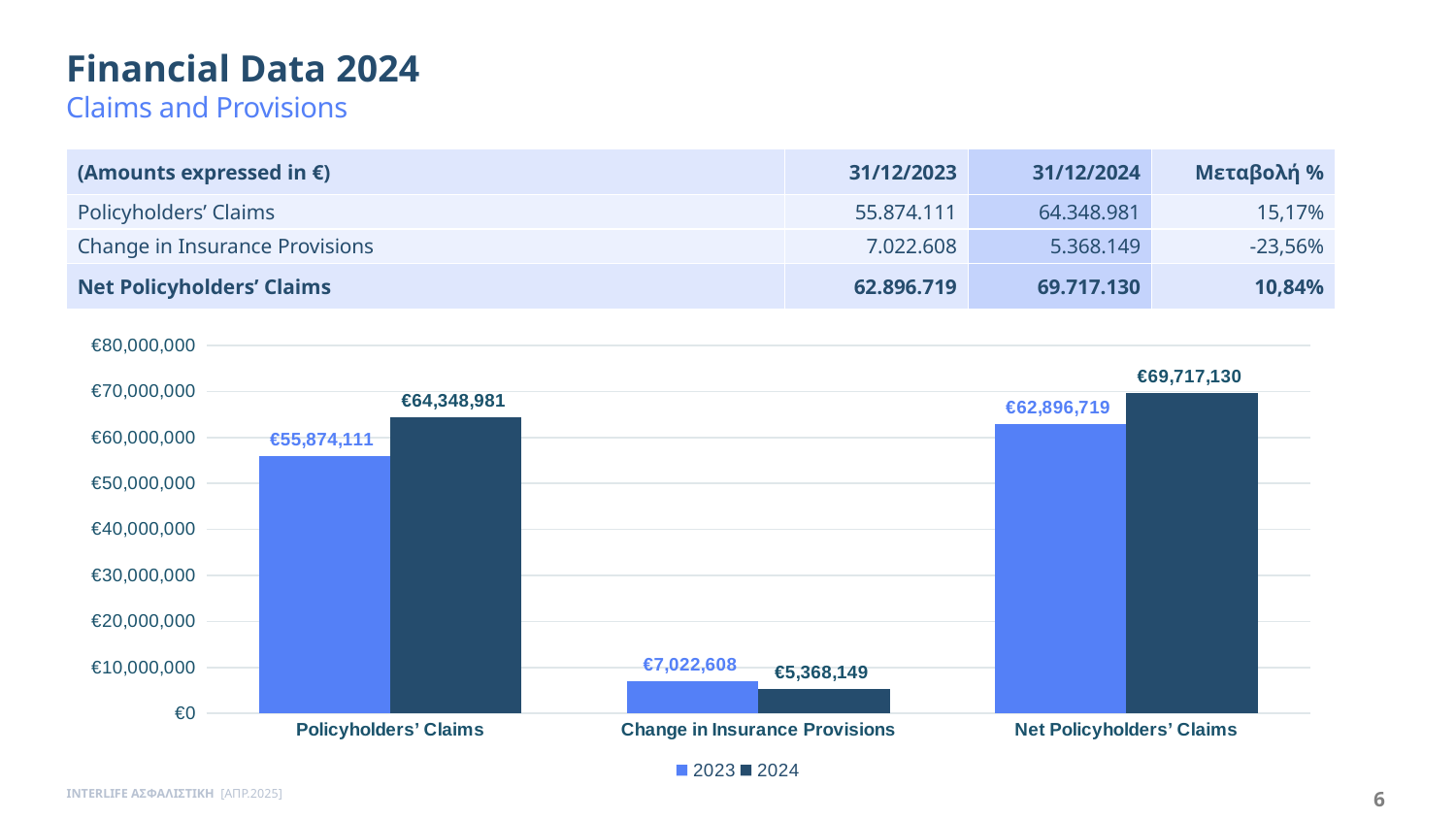
For Change in Insurance Provisions, which year has the larger value, 2023 or 2024? 2023 What is the 2024 value for Net Policyholders' Claims in the chart? €69,717,130 What is the difference between the 2024 and 2023 values for Policyholders' Claims? €8,474,870 What is the 2024 value for Policyholders' Claims in the chart? €64,348,981 How many categories are shown on the x axis of the chart? 3 Which category has the lowest 2023 value in the chart? Change in Insurance Provisions Which category has the highest 2024 value in the chart? Net Policyholders' Claims Is the 2023 value for Net Policyholders' Claims greater or less than €60,000,000? greater How many series does the chart legend list? 2 What kind of chart is shown on the slide? bar chart What is the 2023 value for Change in Insurance Provisions in the chart? €7,022,608 Which series is shown in dark navy in the chart? 2024